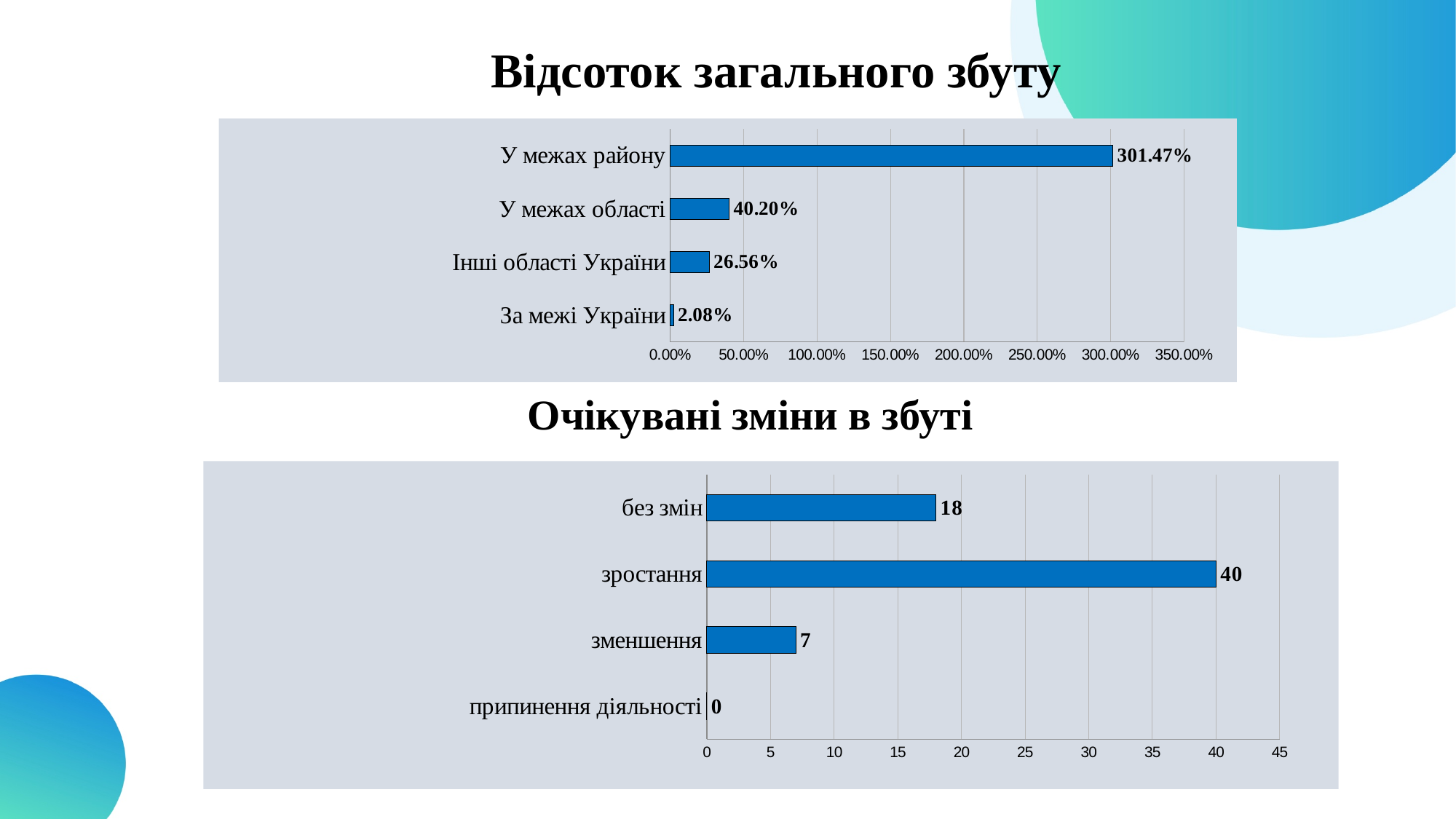
In the chart titled "Очікувані зміни в збуті", what is the value for "зростання"? 40 In the chart titled "Відсоток загального збуту", what kind of chart is it? Bar chart In the chart titled "Очікувані зміни в збуті", which is larger, the value for "без змін" or the value for "зменшення"? без змін In the chart titled "Відсоток загального збуту", which category has the lowest value? За межі України In the chart titled "Відсоток загального збуту", what is the value for "За межі України"? 2.08% In the chart titled "Очікувані зміни в збуті", what is the value for "зменшення"? 7 In the chart titled "Очікувані зміни в збуті", what is the value for "припинення діяльності"? 0 In the chart titled "Відсоток загального збуту", what is the difference between the values for "У межах області" and "Інші області України"? 13.64% In the chart titled "Відсоток загального збуту", how many categories are shown? 4 In the chart titled "Очікувані зміни в збуті", what is the difference between the values for "зростання" and "без змін"? 22 In the chart titled "Відсоток загального збуту", what is the value for "У межах району"? 301.47% In the chart titled "Очікувані зміни в збуті", which category has the highest value? зростання